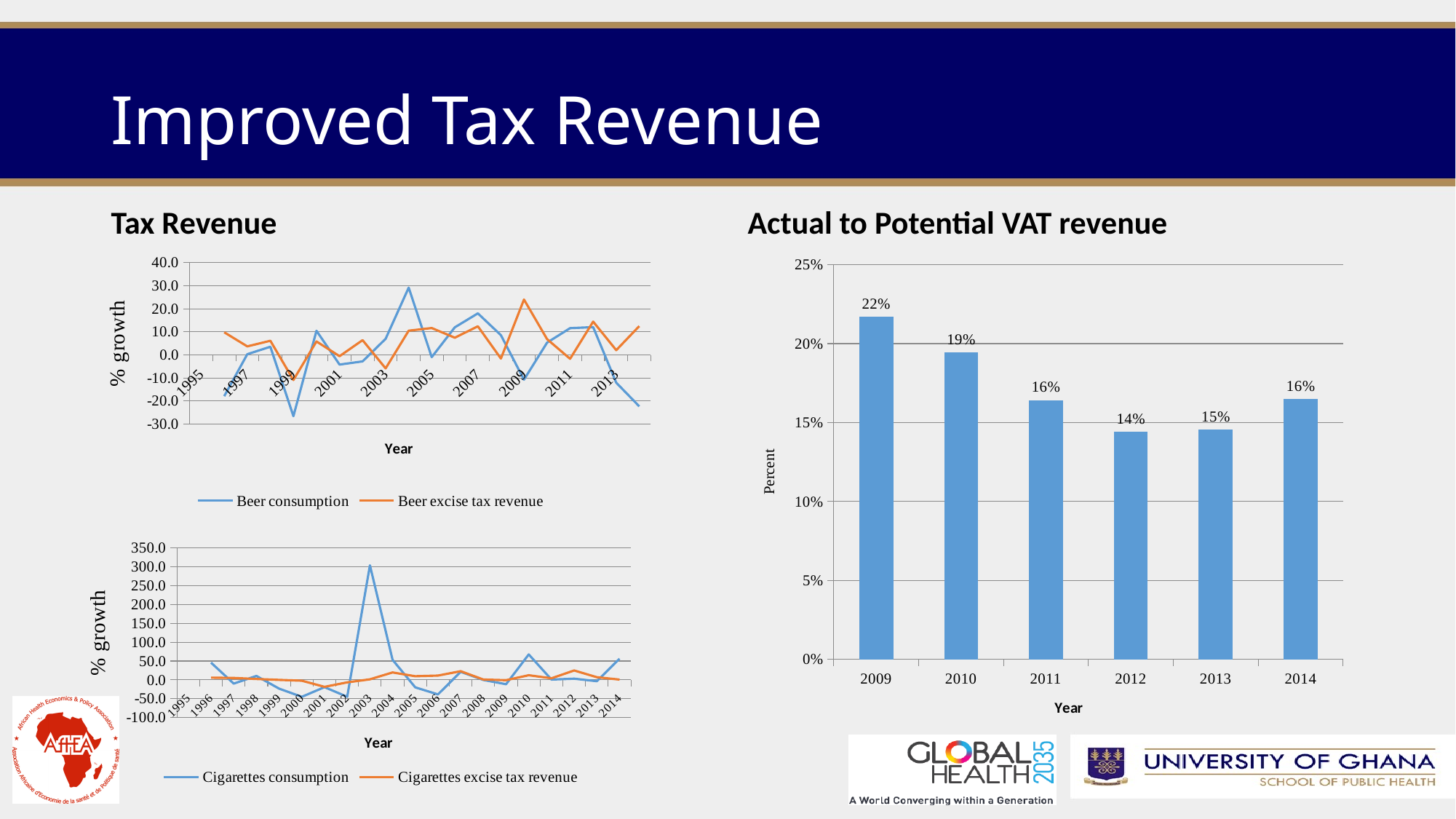
In the 'Actual to Potential VAT revenue' chart, do the values rise or fall from 2009 to 2012? fall In the 'Actual to Potential VAT revenue' chart, which year has the lowest value? 2012 In the bottom-left line chart, in which year does Cigarettes consumption reach its highest % growth? 2003 How many years are shown in the 'Actual to Potential VAT revenue' chart? 6 In the 'Actual to Potential VAT revenue' chart, which is larger, the value for 2013 or the value for 2014? 2014 What kind of chart is the 'Actual to Potential VAT revenue' chart? bar chart In the 'Actual to Potential VAT revenue' chart, which year has the highest value? 2009 How many series does the legend of the top-left line chart (beer) list? 2 In the 'Actual to Potential VAT revenue' chart, what is the value for 2009? 22% In the 'Actual to Potential VAT revenue' chart, what is the difference between the 2009 and 2010 values? 3% In the 'Actual to Potential VAT revenue' chart, what is the value for 2012? 14% In the bottom-left line chart, is the Cigarettes consumption value for 2003 greater or less than 250.0? greater